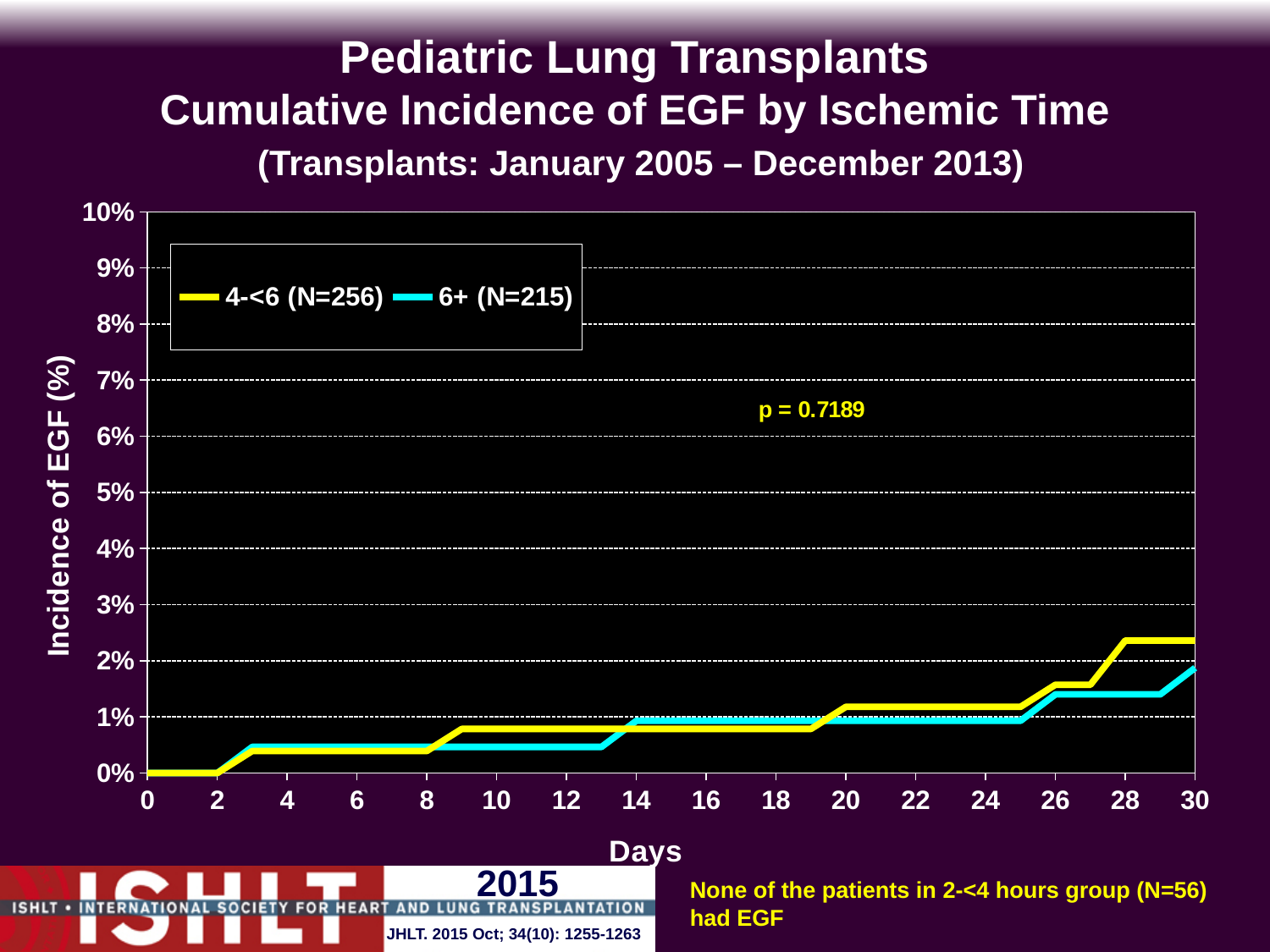
Is the incidence of EGF for the 6+ (N=215) group at day 30 greater or less than 1%? greater Is the incidence of EGF for the 4-<6 (N=256) group at day 10 greater or less than 1%? less What are the two series named in the legend? 4-<6 (N=256) and 6+ (N=215) How many series does the legend list? 2 Is the incidence of EGF for the 4-<6 (N=256) group at day 30 greater or less than 2%? greater At day 30, which group has the higher incidence of EGF, 4-<6 (N=256) or 6+ (N=215)? 4-<6 (N=256) What p-value is printed on the chart? p = 0.7189 Do the cumulative incidence values for the 6+ (N=215) group rise or fall as days increase? rise What is the highest value shown on the y axis of the chart? 10% What kind of chart is shown on the slide? line chart Do the cumulative incidence values for the 4-<6 (N=256) group rise or fall as days increase? rise